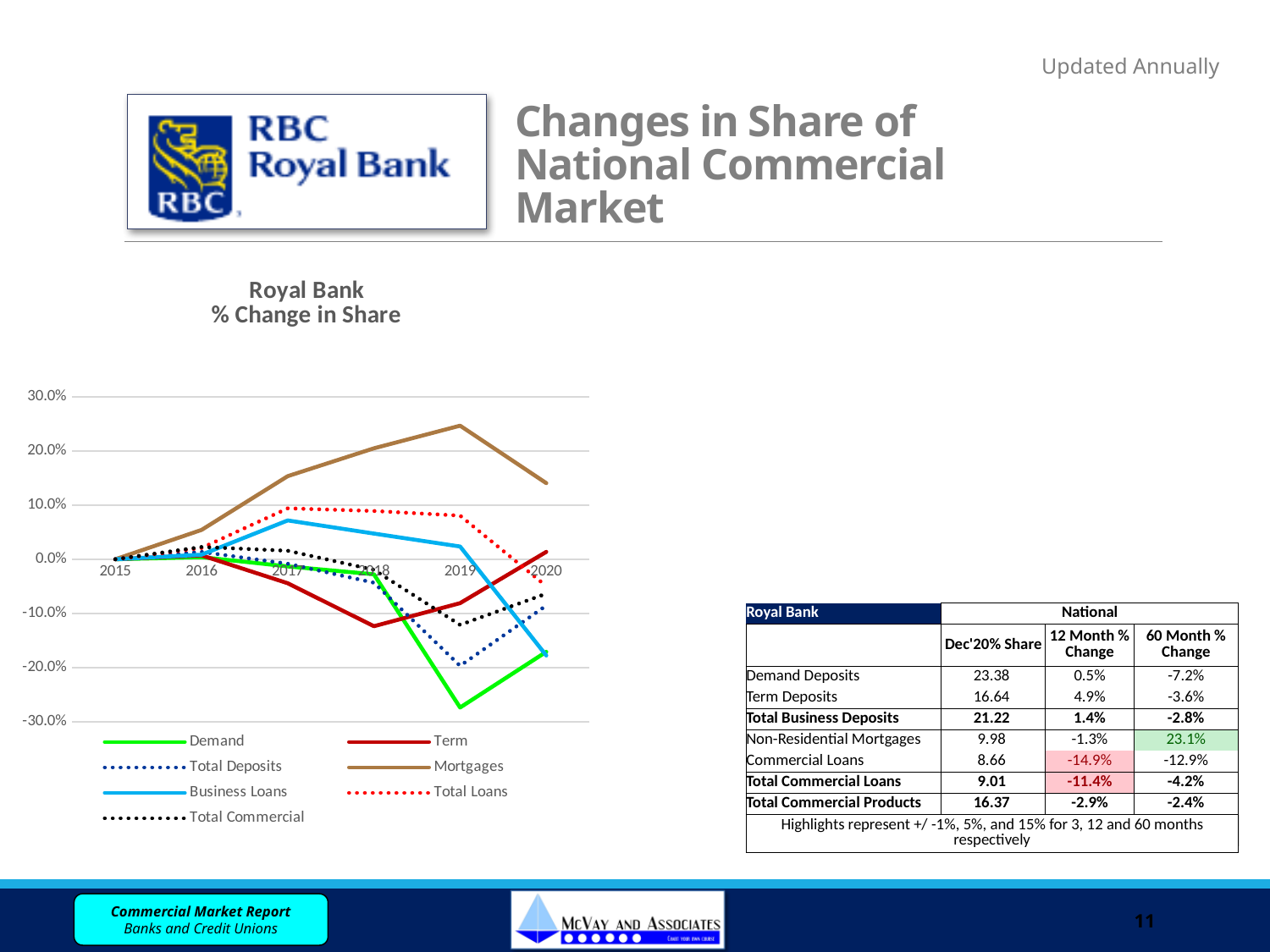
In the 'Royal Bank % Change in Share' chart, which series has the highest value in 2020? Mortgages In the 'Royal Bank % Change in Share' chart, which is larger in 2020: Mortgages or Demand? Mortgages In the 'Royal Bank % Change in Share' chart, is the value for Demand in 2019 greater or less than -20.0%? less What kind of chart is the 'Royal Bank % Change in Share' chart? line chart In the 'Royal Bank % Change in Share' chart, which series has the lowest value in 2019? Demand In the 'Royal Bank % Change in Share' chart, which series has the highest value in 2019? Mortgages In the 'Royal Bank % Change in Share' chart, does the Mortgages series rise or fall from 2015 to 2019? rise How many series does the legend of the 'Royal Bank % Change in Share' chart list? 7 How many years are shown on the x axis of the 'Royal Bank % Change in Share' chart? 6 In the 'Royal Bank % Change in Share' chart, is the value for Term in 2018 greater or less than -10.0%? less What is the title of the line chart on the slide? Royal Bank % Change in Share In the 'Royal Bank % Change in Share' chart, is the value for Mortgages in 2019 greater or less than 20.0%? greater